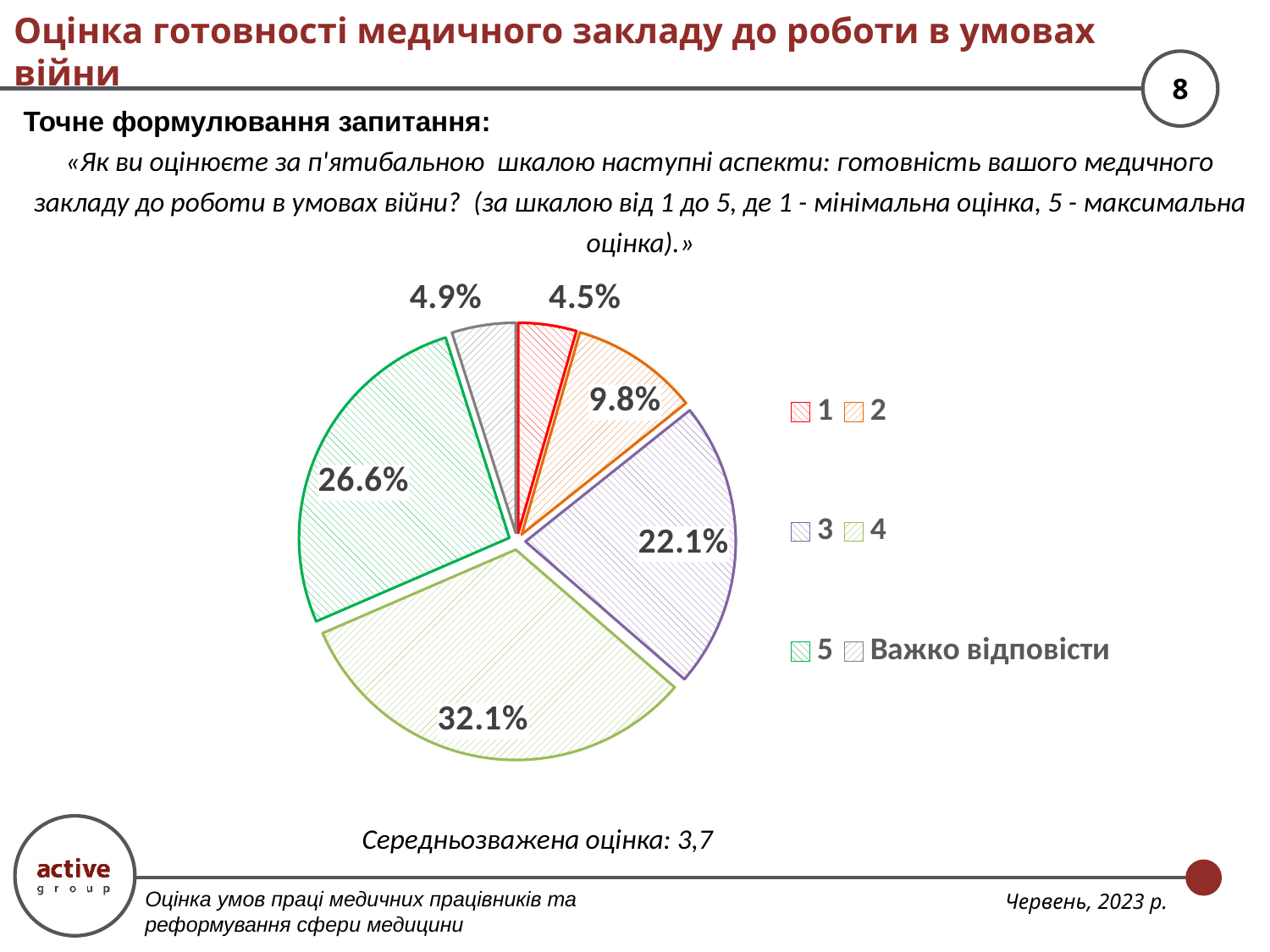
How many categories does the legend list? 6 What weighted average score is stated below the chart? 3,7 What is the difference in percentage points between the shares for ratings 4 and 5? 5.5 What share of respondents gave a rating of 3? 22.1% Which is larger: the share for rating 2 or the share for rating 3? 3 What type of chart is shown on the slide? pie chart What share of respondents gave a rating of 4? 32.1% What share of respondents answered "Важко відповісти"? 4.9% Which category has the smallest share of the pie? 1 Which rating category has the largest share of the pie? 4 What is the combined share of respondents who gave a rating of 4 or 5? 58.7% What share of respondents gave a rating of 1? 4.5%